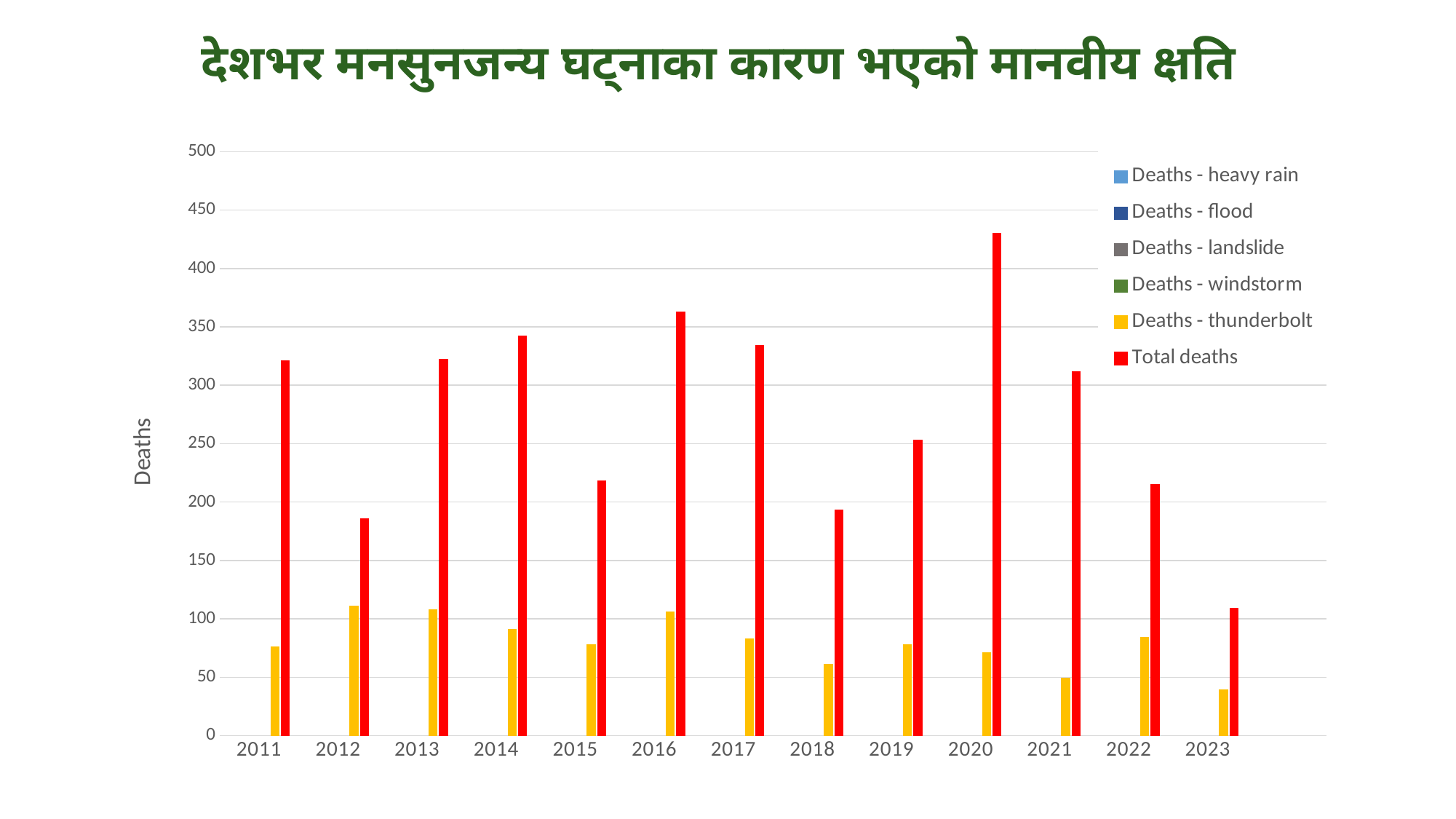
Is the Total deaths value for 2012 greater or less than 200? less In which year is the Total deaths bar lowest? 2023 In which year is the Deaths - thunderbolt bar lowest? 2023 In which year is the Total deaths bar highest? 2020 Is the Deaths - thunderbolt value for 2012 greater or less than 100? greater Is the Total deaths value for 2020 greater or less than 400? greater What kind of chart is shown on the slide? bar chart How many series does the chart's legend list? 6 What is the label on the vertical axis of the chart? Deaths How many years are shown on the x axis of the chart? 13 Which year has the larger Total deaths value, 2016 or 2017? 2016